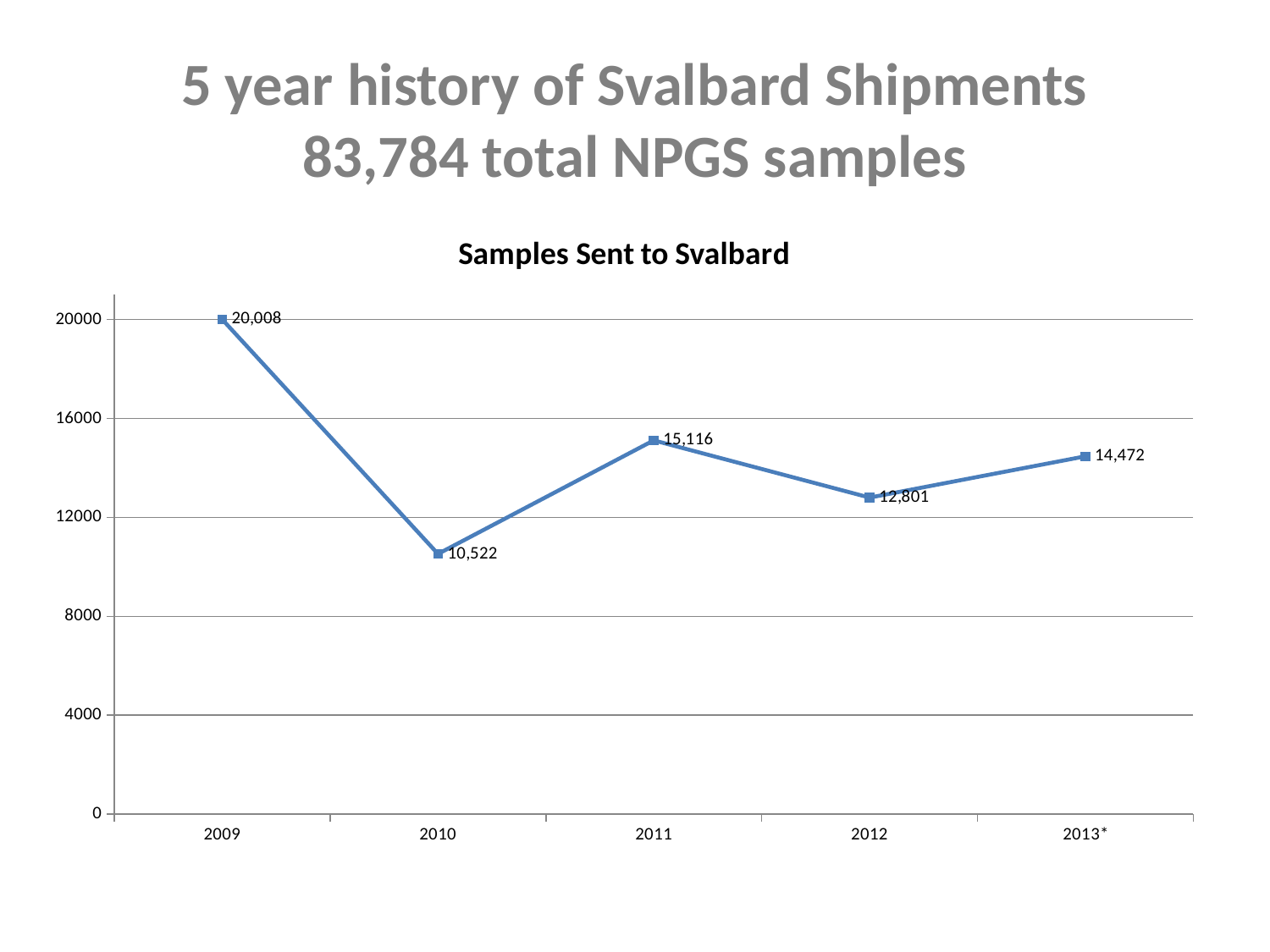
Which year has the lowest value in the Samples Sent to Svalbard chart? 2010 Is the value for 2012 in the Samples Sent to Svalbard chart greater or less than 12000? greater How many years are plotted in the Samples Sent to Svalbard chart? 5 What is the value for 2010 in the Samples Sent to Svalbard chart? 10,522 What is the value for 2013* in the Samples Sent to Svalbard chart? 14,472 Which is larger in the Samples Sent to Svalbard chart, the value for 2011 or the value for 2013*? 2011 Does the value rise or fall from 2012 to 2013* in the Samples Sent to Svalbard chart? rise What is the difference between the values for 2009 and 2010 in the Samples Sent to Svalbard chart? 9,486 Which year has the highest value in the Samples Sent to Svalbard chart? 2009 What is the difference between the values for 2011 and 2012 in the Samples Sent to Svalbard chart? 2,315 What is the value for 2009 in the Samples Sent to Svalbard chart? 20,008 What kind of chart is the Samples Sent to Svalbard chart? line chart